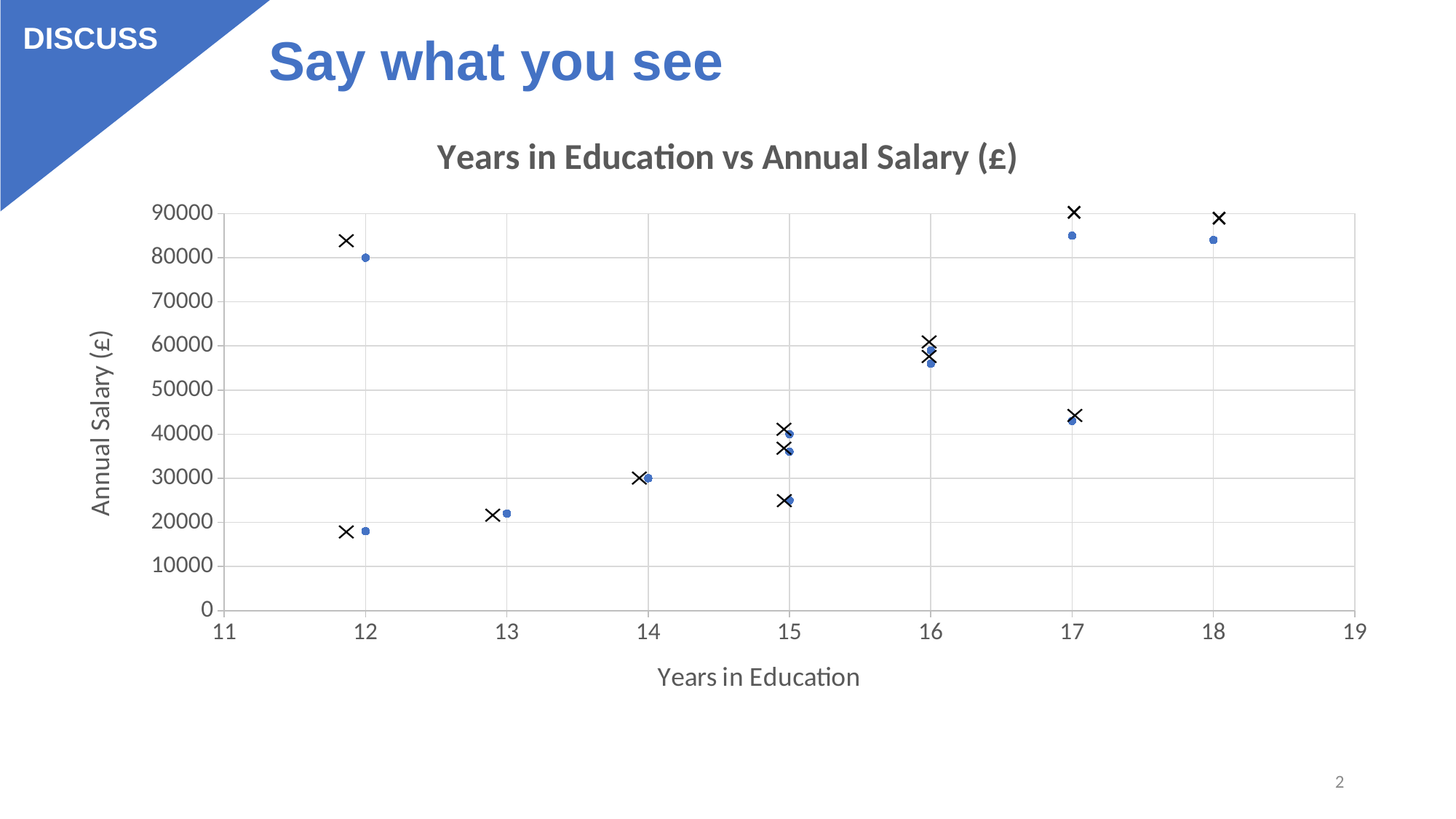
Is the lower of the two points at 17 years in education greater or less than 40000? greater What is the annual salary for the point at 14 years in education? 30000 Are the points at 16 years in education greater or less than 50000 in annual salary? greater What kind of chart is shown on the slide? Scatter chart Is the annual salary for the point at 18 years in education greater or less than 80000? greater What is the title of the chart? Years in Education vs Annual Salary (£) What is the label on the vertical axis of the chart? Annual Salary (£) Which has the higher annual salary: the point at 13 years in education or the point at 14 years in education? 14 years in education How many points are plotted at 15 years in education? 3 At how many years in education is the lowest annual salary point plotted? 12